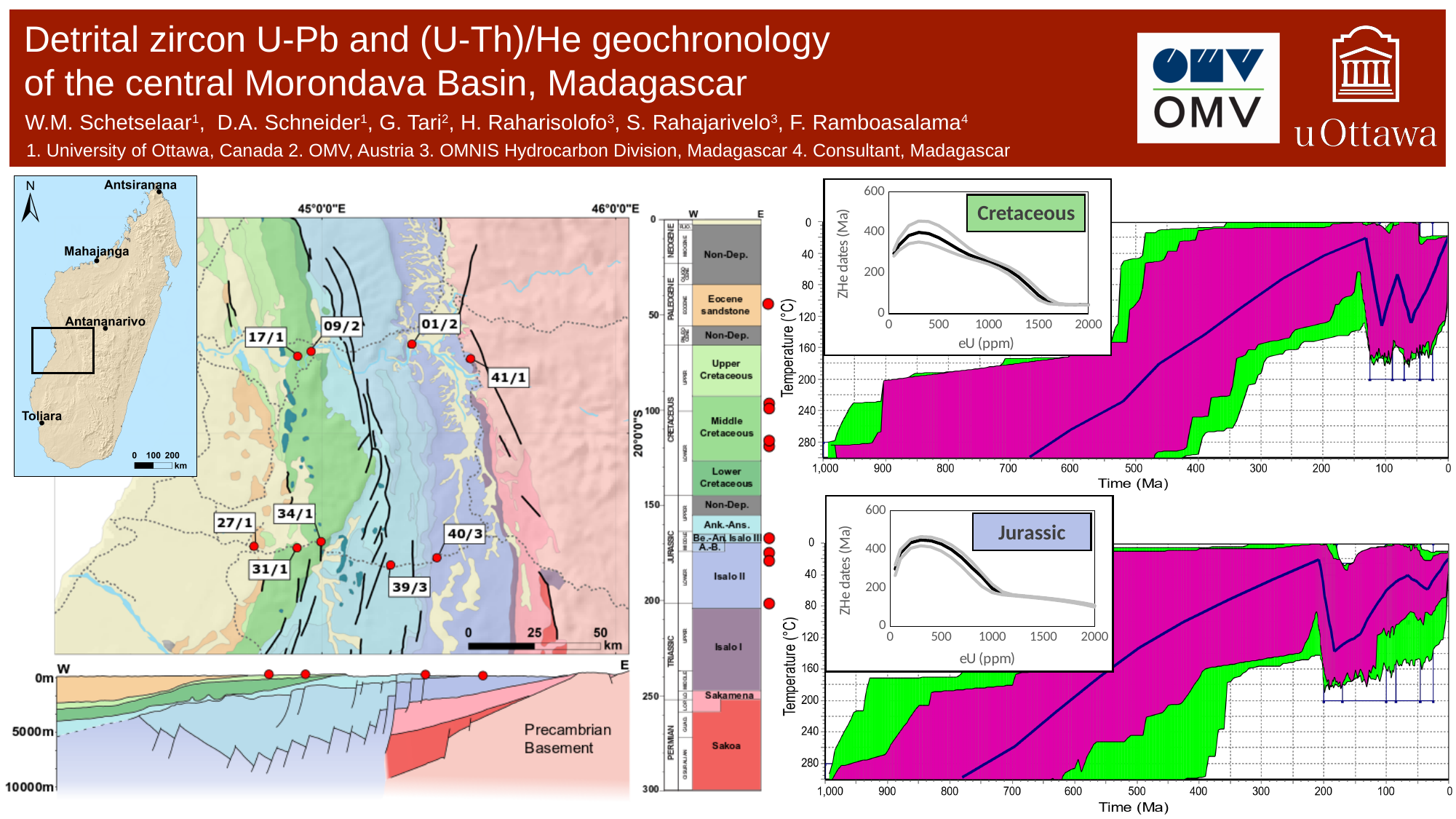
What is the label of the y axis on the Cretaceous and Jurassic inset charts? ZHe dates (Ma) In the Jurassic inset chart, is the ZHe date at 500 ppm eU greater or less than 200 Ma? greater In the Cretaceous thermal history chart (upper right), is the temperature on the dark blue line at 500 Ma greater or less than 200 °C? greater What is the label of the x axis on the two thermal history charts on the right? Time (Ma) In the Cretaceous inset chart, do ZHe dates rise or fall as eU increases from 500 ppm to 1500 ppm? fall What kind of chart is the Cretaceous inset plotting ZHe dates against eU? line chart In the Jurassic inset chart, is the ZHe date at 2000 ppm eU greater or less than 200 Ma? less In the Cretaceous thermal history chart (upper right), does the dark blue line show temperature rising or falling as time moves from 600 Ma toward 0 Ma? falling